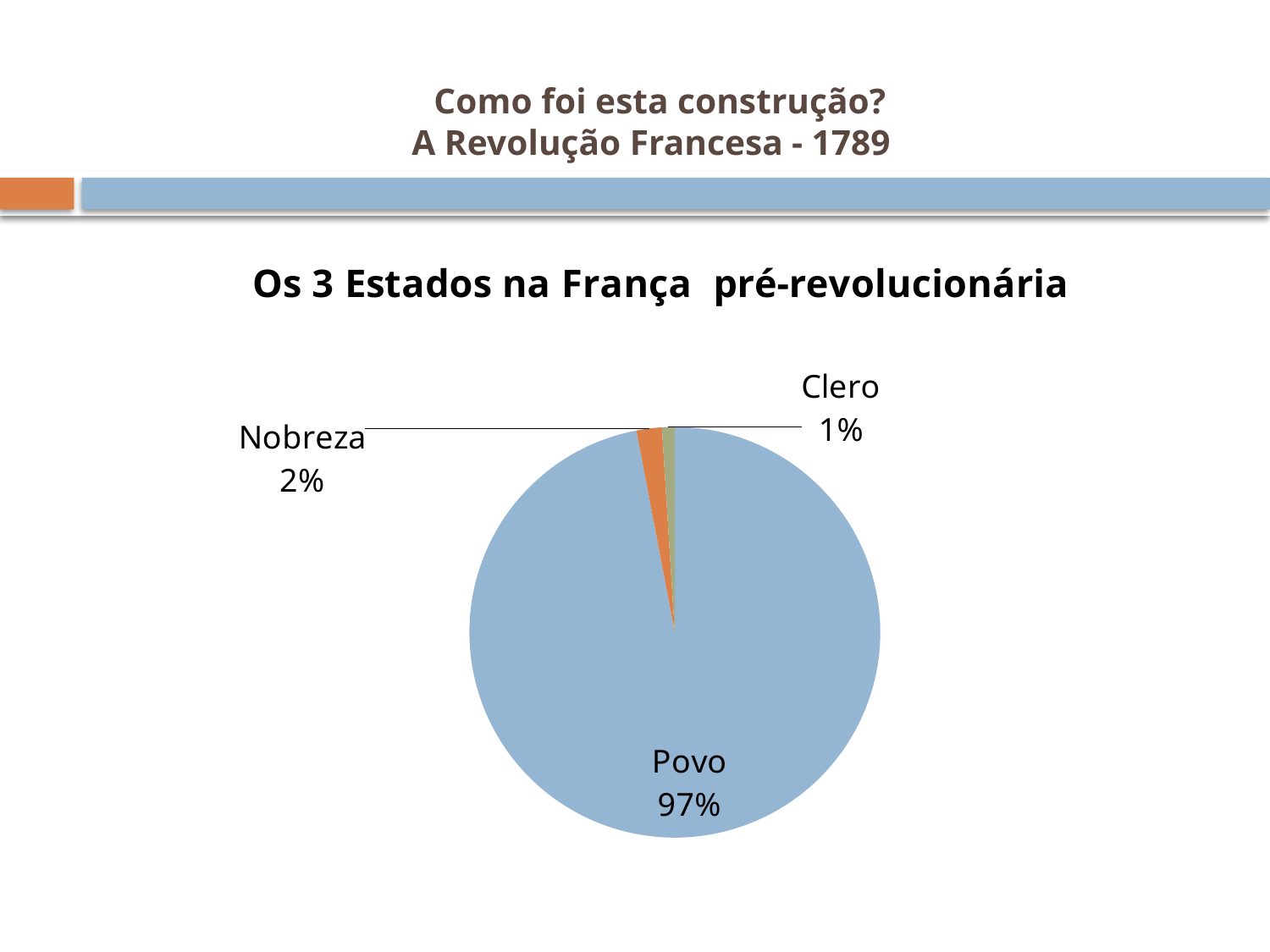
What share of the pie does Clero represent? 1% What is the difference in percentage points between Povo and Nobreza? 95 Which category has the largest slice of the pie? Povo Which category has the smallest slice of the pie? Clero How many slices does the pie chart have? 3 What share of the pie does Nobreza represent? 2% What kind of chart is shown on the slide? pie chart What share of the pie does Povo represent? 97% Which is larger, the share for Nobreza or the share for Clero? Nobreza What is the difference in percentage points between Nobreza and Clero? 1 What is the title of the chart? Os 3 Estados na França pré-revolucionária What colour is the Povo slice of the pie? blue